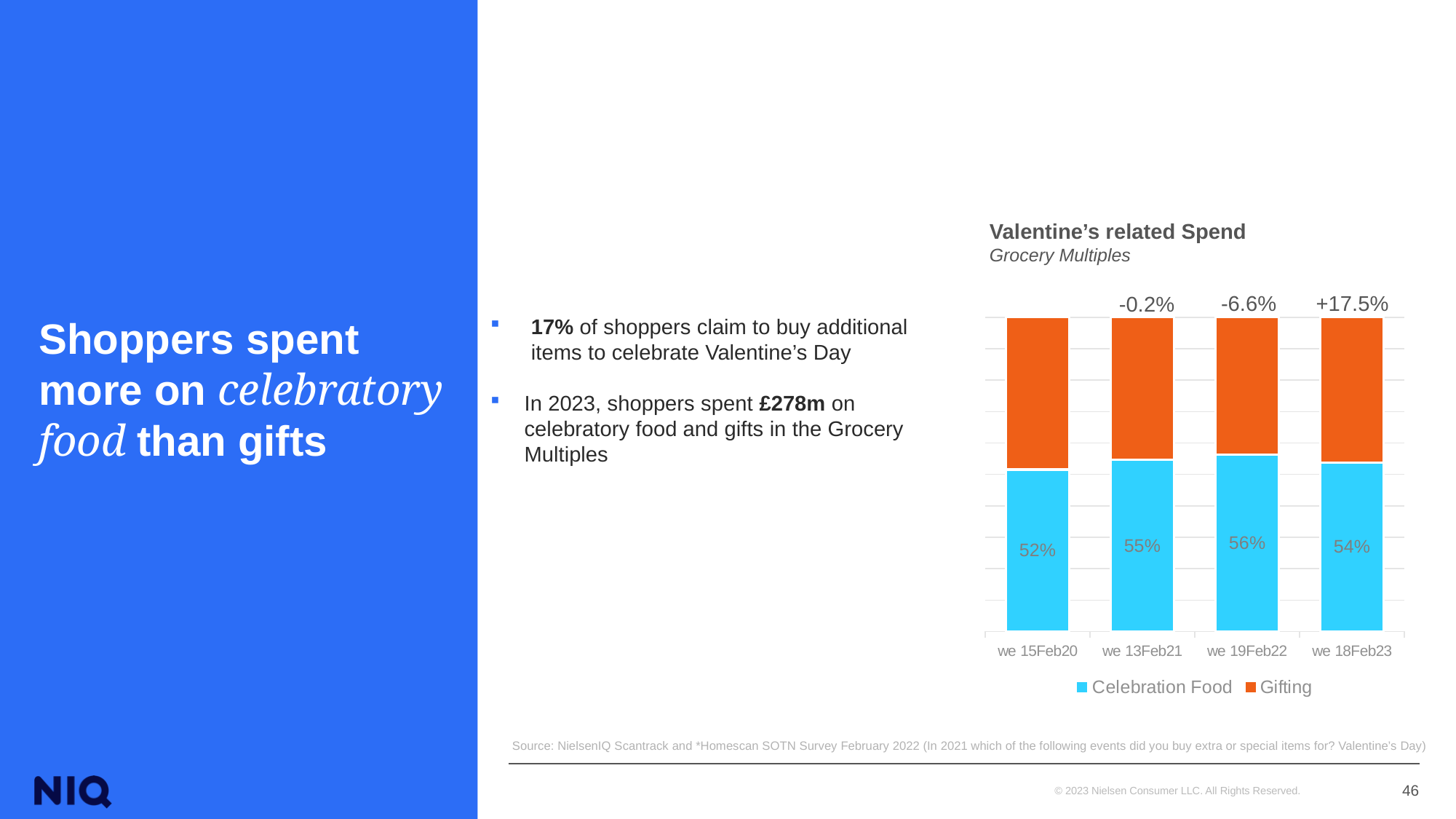
What is the Celebration Food share for we 18Feb23? 54% How many periods are shown on the x axis? 4 Which period has the lowest Celebration Food share? we 15Feb20 What are the two legend entries of the chart? Celebration Food and Gifting What is the difference in Celebration Food share between we 19Feb22 and we 15Feb20? 4 percentage points Which has the larger Celebration Food share, we 13Feb21 or we 18Feb23? we 13Feb21 What is the Celebration Food share for we 19Feb22? 56% What percentage change is printed above the we 18Feb23 bar? +17.5% How many series does the legend list? 2 What kind of chart is shown? Stacked bar chart Which period has the highest Celebration Food share? we 19Feb22 What is the Celebration Food share for we 15Feb20? 52%